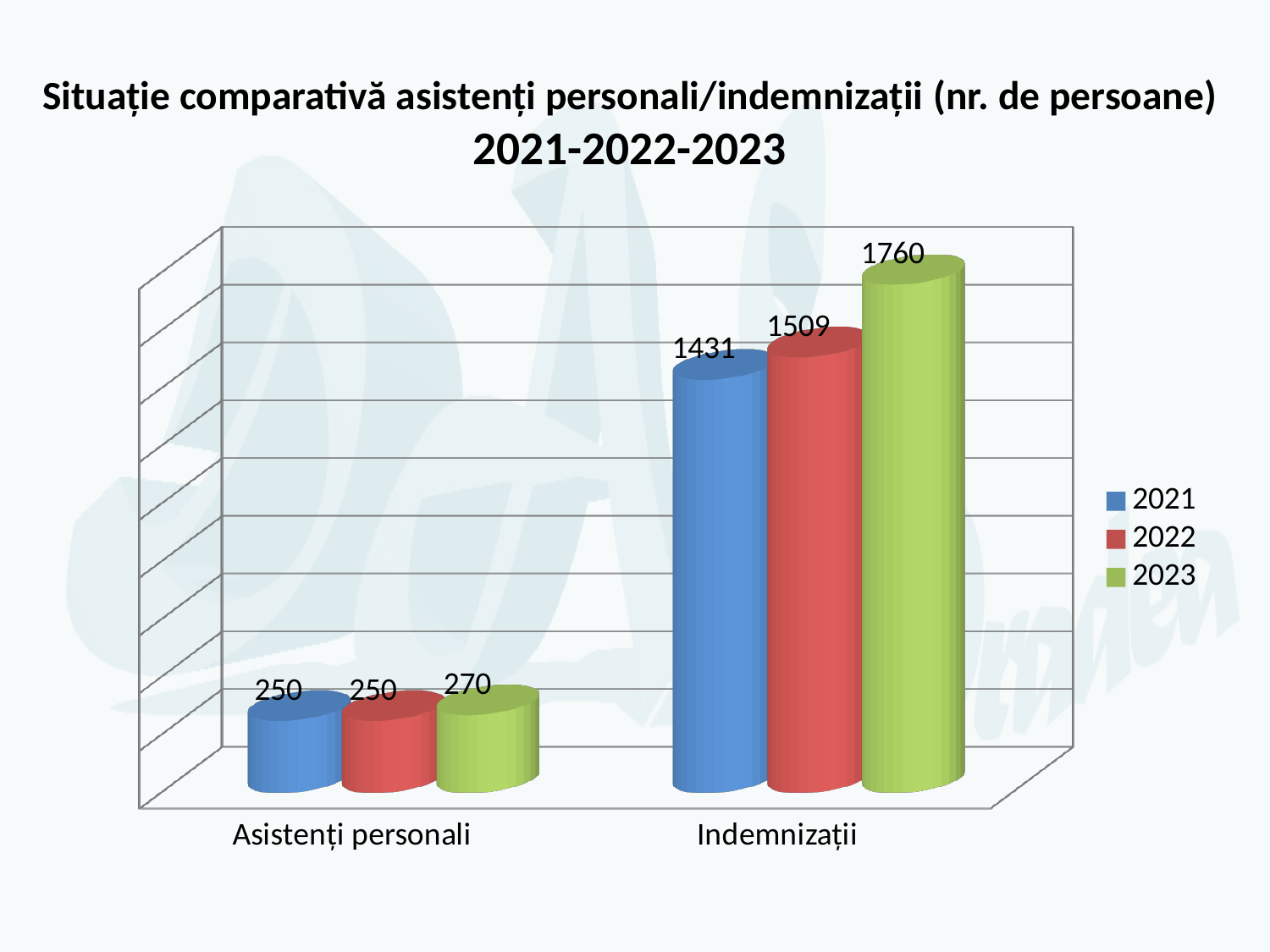
Which is larger: Indemnizații in 2021 or Indemnizații in 2022? Indemnizații in 2022 What is the value for Asistenți personali in 2021? 250 What is the value for Indemnizații in 2023? 1760 What is the value for Indemnizații in 2022? 1509 What is the difference between the Indemnizații values for 2023 and 2022? 251 How many categories are shown on the x axis? 2 How many series does the legend list? 3 What kind of chart is shown on the slide? Bar chart Which year has the lowest value for Indemnizații? 2021 What is the difference between the Asistenți personali values for 2023 and 2021? 20 Which year has the highest value for Indemnizații? 2023 What is the value for Asistenți personali in 2023? 270